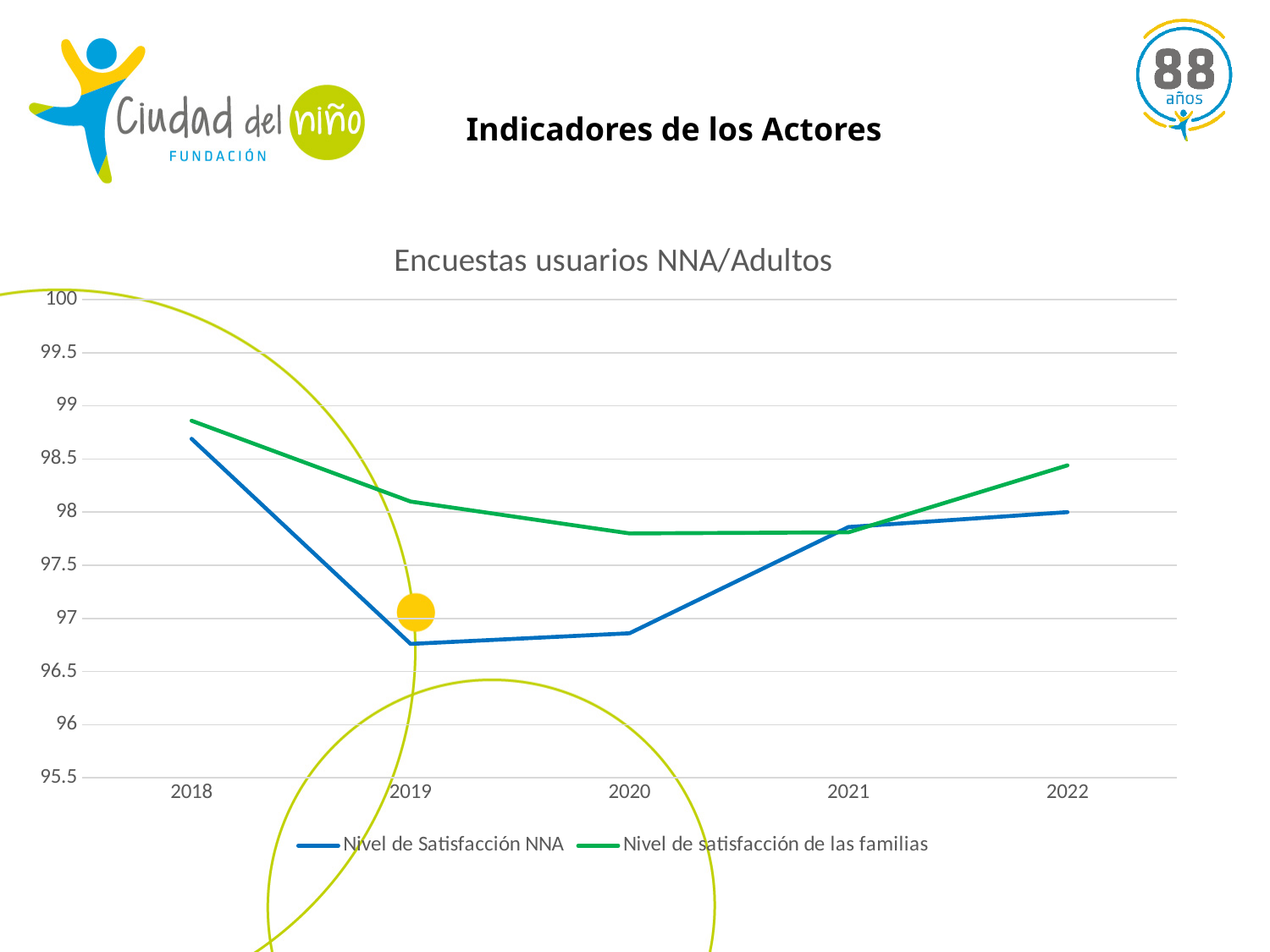
How many series does the legend list? 2 In which year is the Nivel de Satisfacción NNA highest? 2018 Is the Nivel de Satisfacción NNA value for 2019 greater or less than 97? less Does the Nivel de Satisfacción NNA rise or fall from 2019 to 2022? rise Is the Nivel de satisfacción de las familias value for 2020 greater or less than 98? less What is the title of the chart? Encuestas usuarios NNA/Adultos How many years are shown on the x axis? 5 Is the Nivel de Satisfacción NNA value for 2018 greater or less than 98.5? greater What type of chart is shown on the slide? line chart In 2019, which series has the higher value: Nivel de Satisfacción NNA or Nivel de satisfacción de las familias? Nivel de satisfacción de las familias In which year is the Nivel de satisfacción de las familias highest? 2018 In which year is the Nivel de Satisfacción NNA lowest? 2019